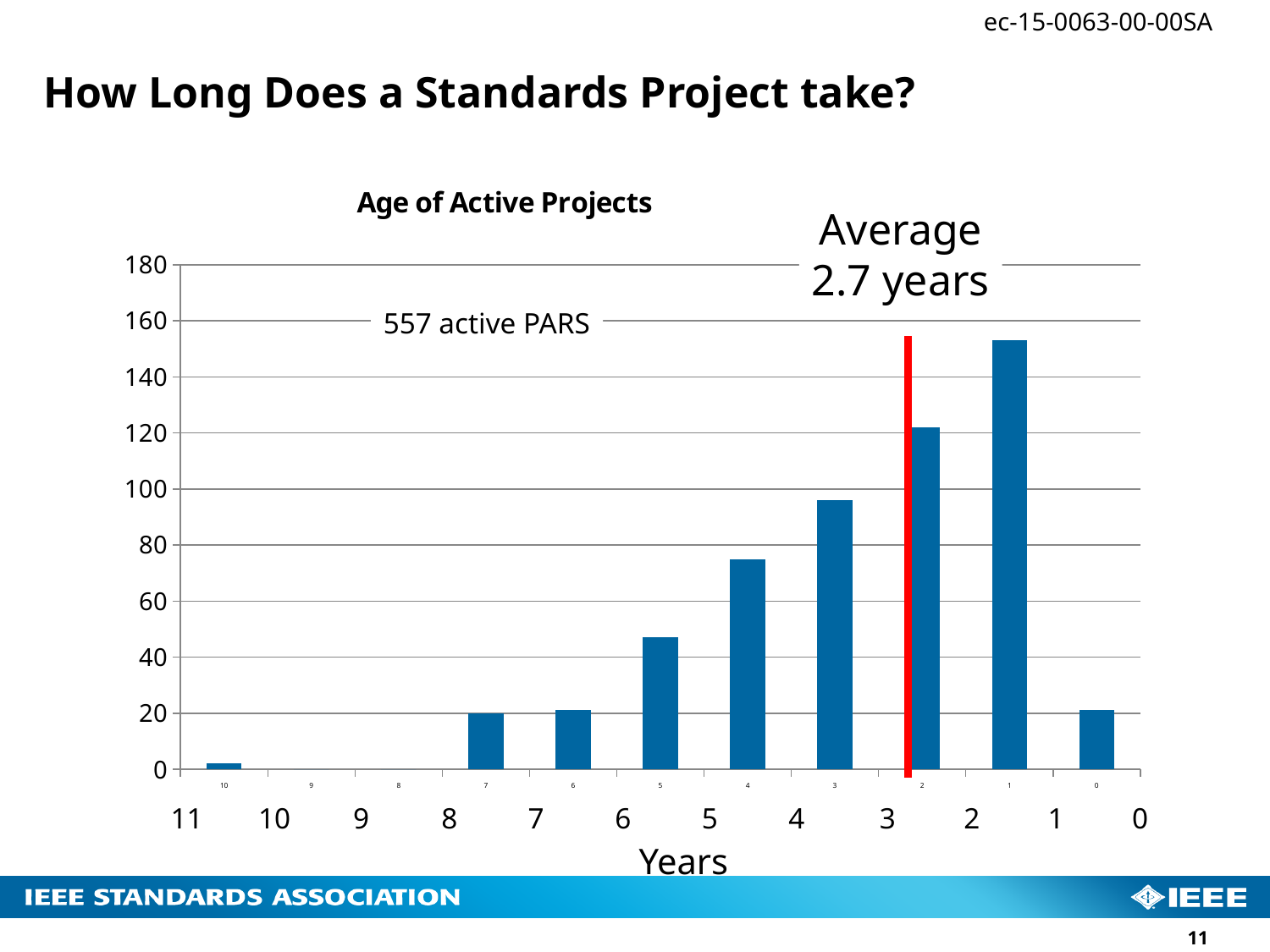
Is the value for year 5 greater or less than 60? less Is the value for year 1 greater or less than 140? greater Which has the larger value, year 2 or year 3? year 2 Do the bar values rise or fall going from year 7 to year 1? rise What average value is annotated on the chart? 2.7 years Is the value for year 2 greater or less than 100? greater Which year category has the tallest bar? 1 What kind of chart is shown on the slide? bar chart What is the title of the chart? Age of Active Projects